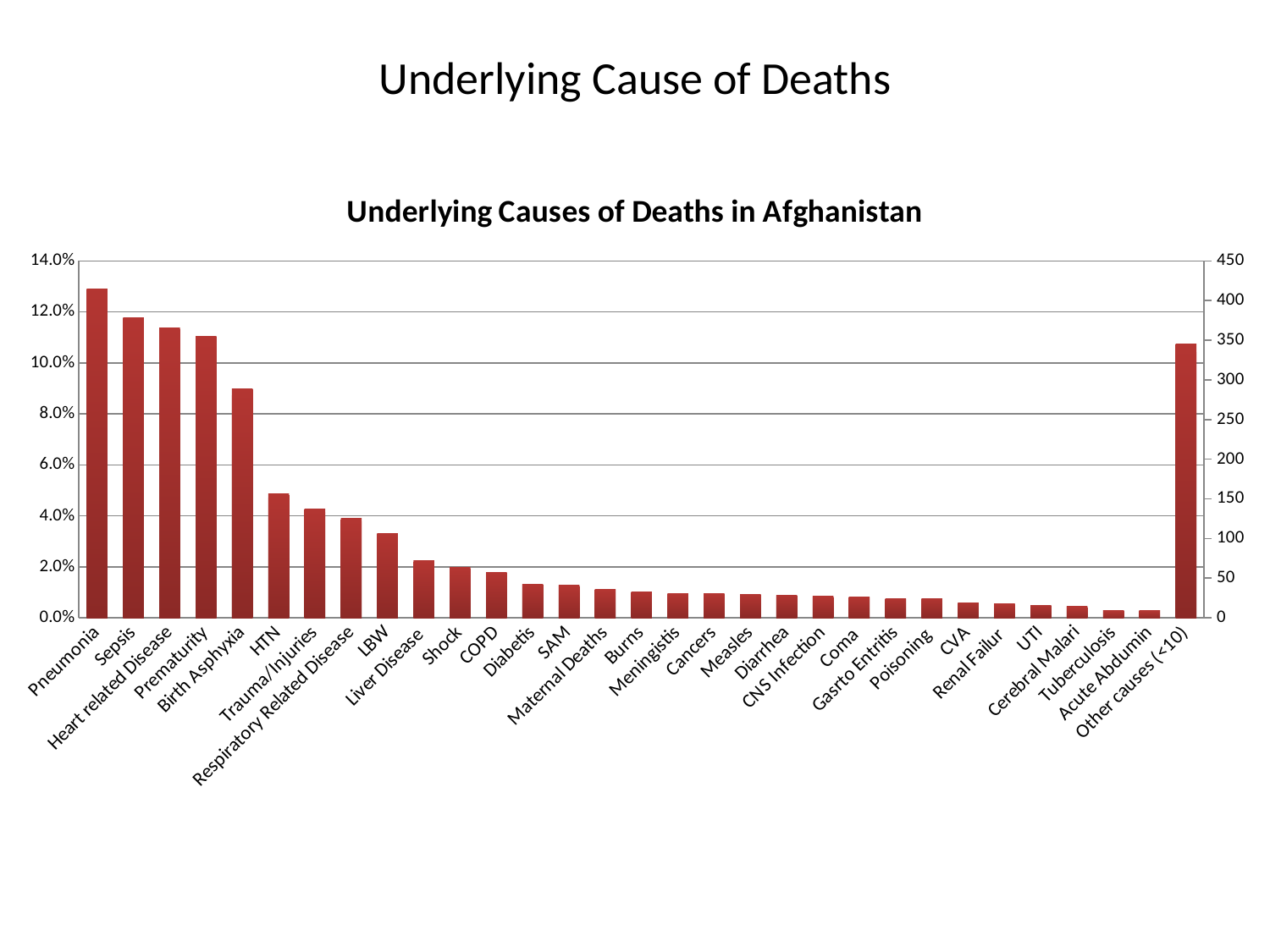
Is the value for Pneumonia greater or less than 12.0%? greater What is the title of the chart? Underlying Causes of Deaths in Afghanistan Is the value for Birth Asphyxia greater or less than 8.0%? greater Which is larger, the value for Sepsis or the value for Prematurity? Sepsis Which is larger, the value for Pneumonia or the value for Other causes (<10)? Pneumonia Is the value for HTN greater or less than 4.0%? greater Which cause of death has the highest bar in the chart? Pneumonia What kind of chart is shown on the slide? Bar chart How many causes of death are plotted along the x axis? 31 Do the values rise or fall from Pneumonia through Acute Abdumin along the x axis? fall